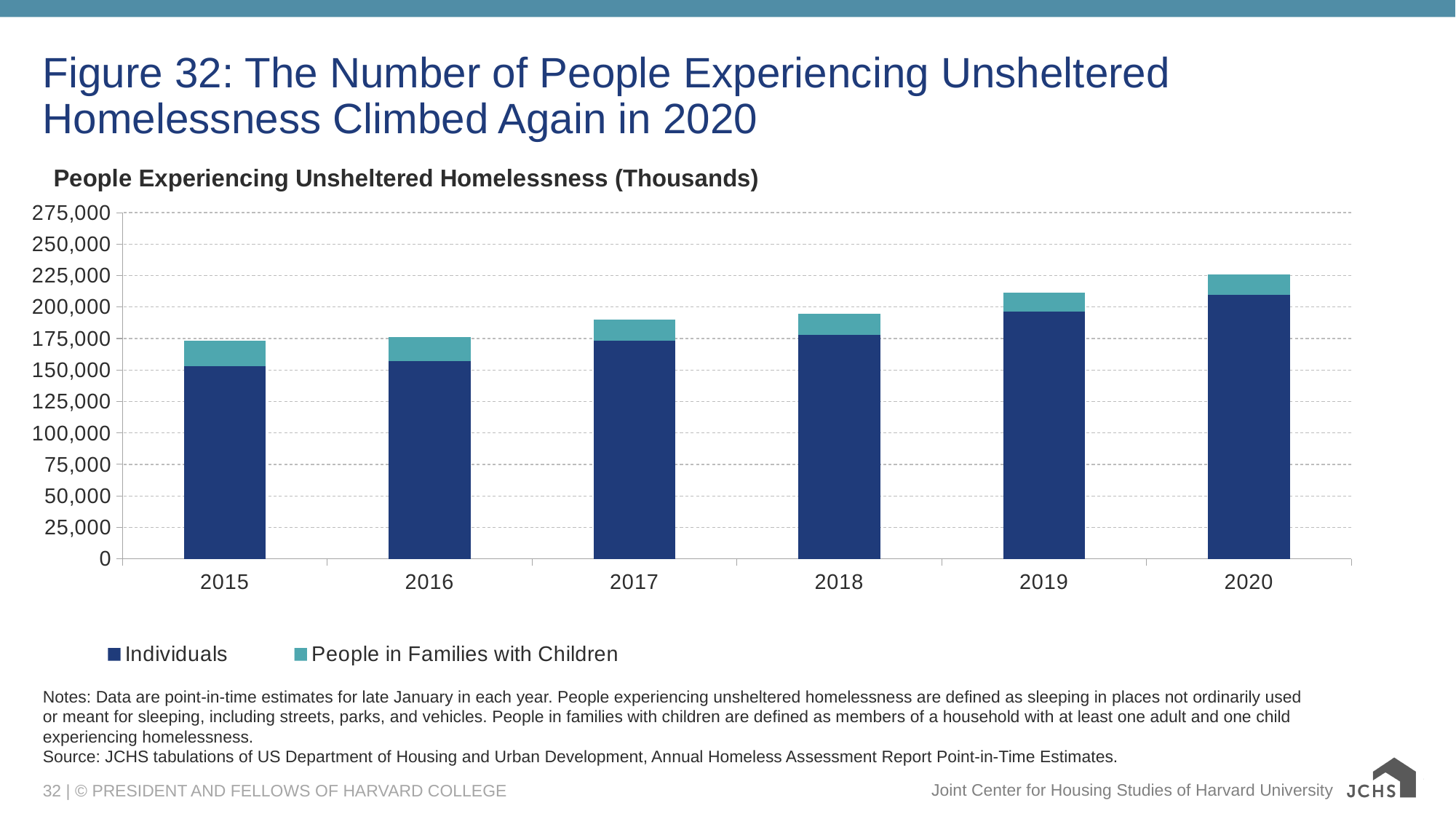
Is the value for Individuals in 2016 greater or less than 150,000? greater Do the total bar heights rise or fall from 2015 to 2020? Rise Which is larger, the total bar for 2020 or the total bar for 2015? 2020 Is the total bar height for 2019 greater or less than 200,000? greater Is the value for Individuals in 2020 greater or less than 200,000? greater How many years are shown on the x axis of the chart? 6 Which year has the highest total number of people experiencing unsheltered homelessness? 2020 What kind of chart is shown on the slide? Stacked bar chart Which series is shown in dark blue in the chart? Individuals What is the title printed above the chart's plot area? People Experiencing Unsheltered Homelessness (Thousands) How many series does the chart's legend list? 2